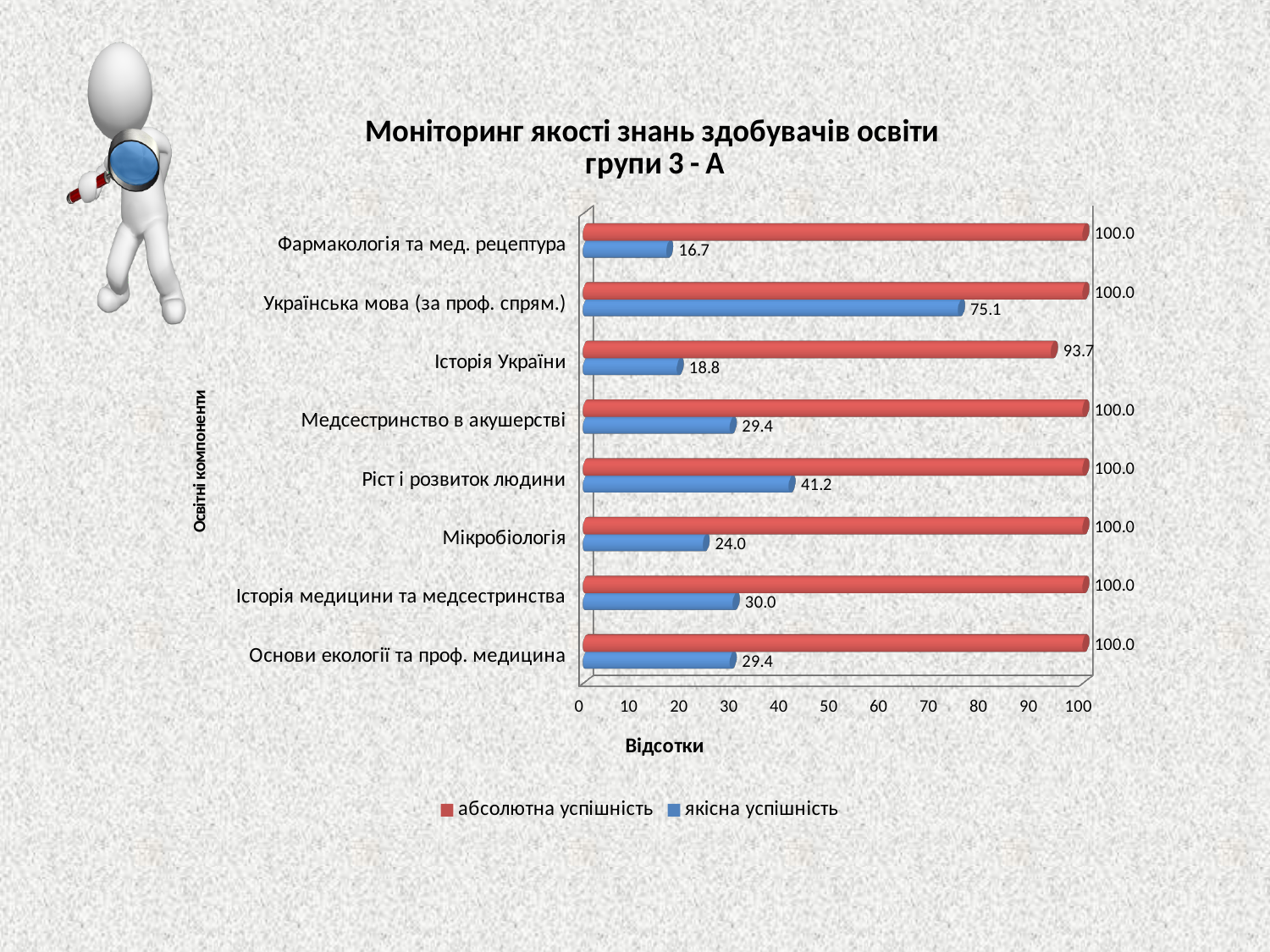
What is the якісна успішність value for Фармакологія та мед. рецептура? 16.7 Which category has the lowest абсолютна успішність value? Історія України What is the абсолютна успішність value for Історія України? 93.7 Which category has the highest якісна успішність value? Українська мова (за проф. спрям.) Which category has the lowest якісна успішність value? Фармакологія та мед. рецептура How many categories are shown on the chart? 8 What kind of chart is shown on the slide? Bar chart What is the якісна успішність value for Мікробіологія? 24.0 What is the якісна успішність value for Українська мова (за проф. спрям.)? 75.1 What is the difference between the абсолютна успішність and якісна успішність values for Ріст і розвиток людини? 58.8 How many series does the legend list? 2 Which is larger: the якісна успішність value for Історія медицини та медсестринства or for Медсестринство в акушерстві? Історія медицини та медсестринства